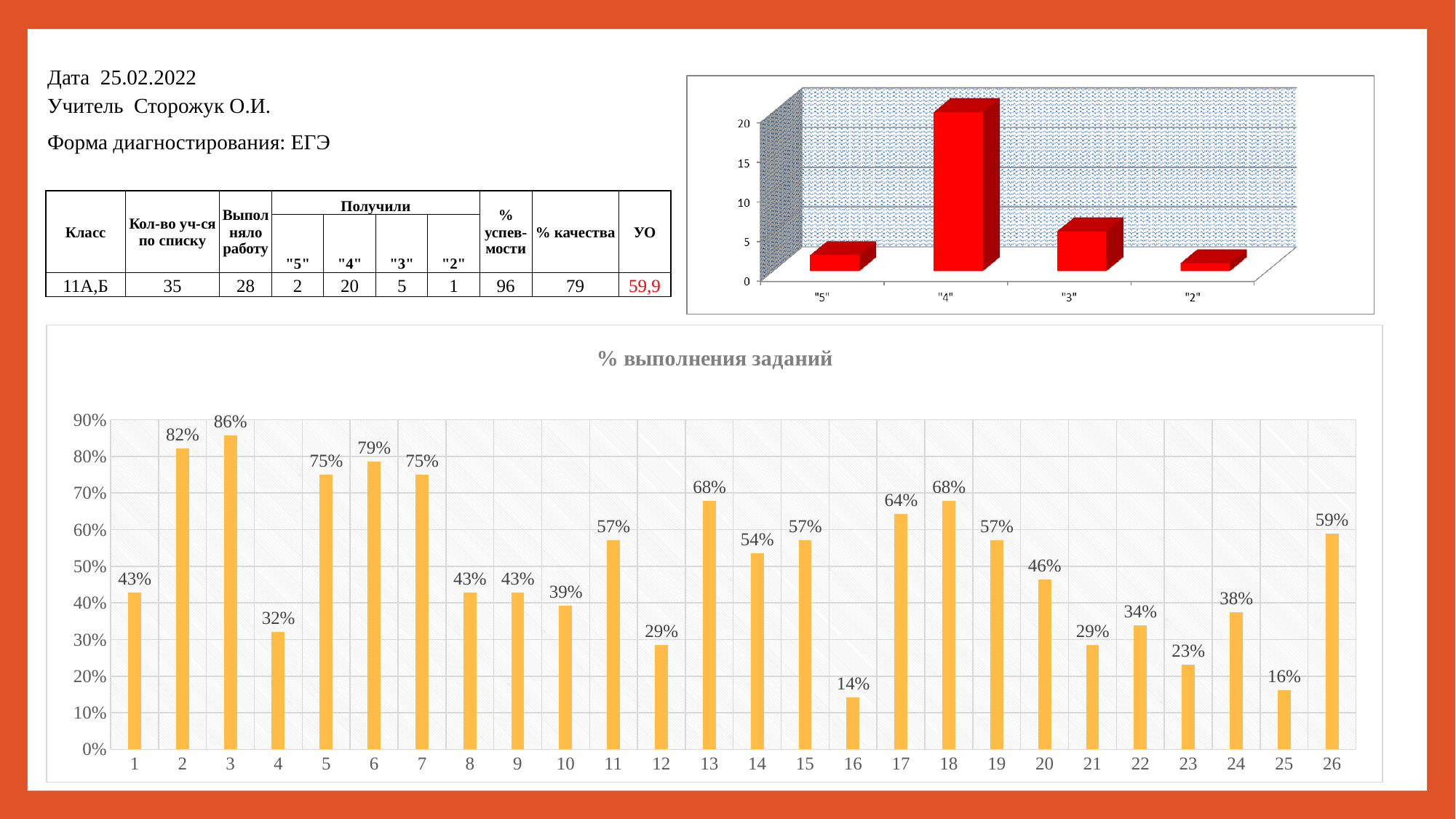
In the chart titled "% выполнения заданий", which task has the highest value? 3 In the top-right chart, which grade category has the tallest bar? "4" In the chart titled "% выполнения заданий", what is the value for task 3? 86% In the chart titled "% выполнения заданий", what is the value for task 26? 59% In the top-right chart, how many categories are shown on the x axis? 4 In the chart titled "% выполнения заданий", what is the difference between the values for task 2 and task 4? 50% In the chart titled "% выполнения заданий", how many tasks are shown on the x axis? 26 In the chart titled "% выполнения заданий", which is larger, the value for task 20 or the value for task 24? task 20 What kind of chart is the chart titled "% выполнения заданий"? bar chart In the chart titled "% выполнения заданий", which task has the lowest value? 16 In the top-right chart, is the value for "4" greater or less than 15? greater In the chart titled "% выполнения заданий", what is the value for task 16? 14%